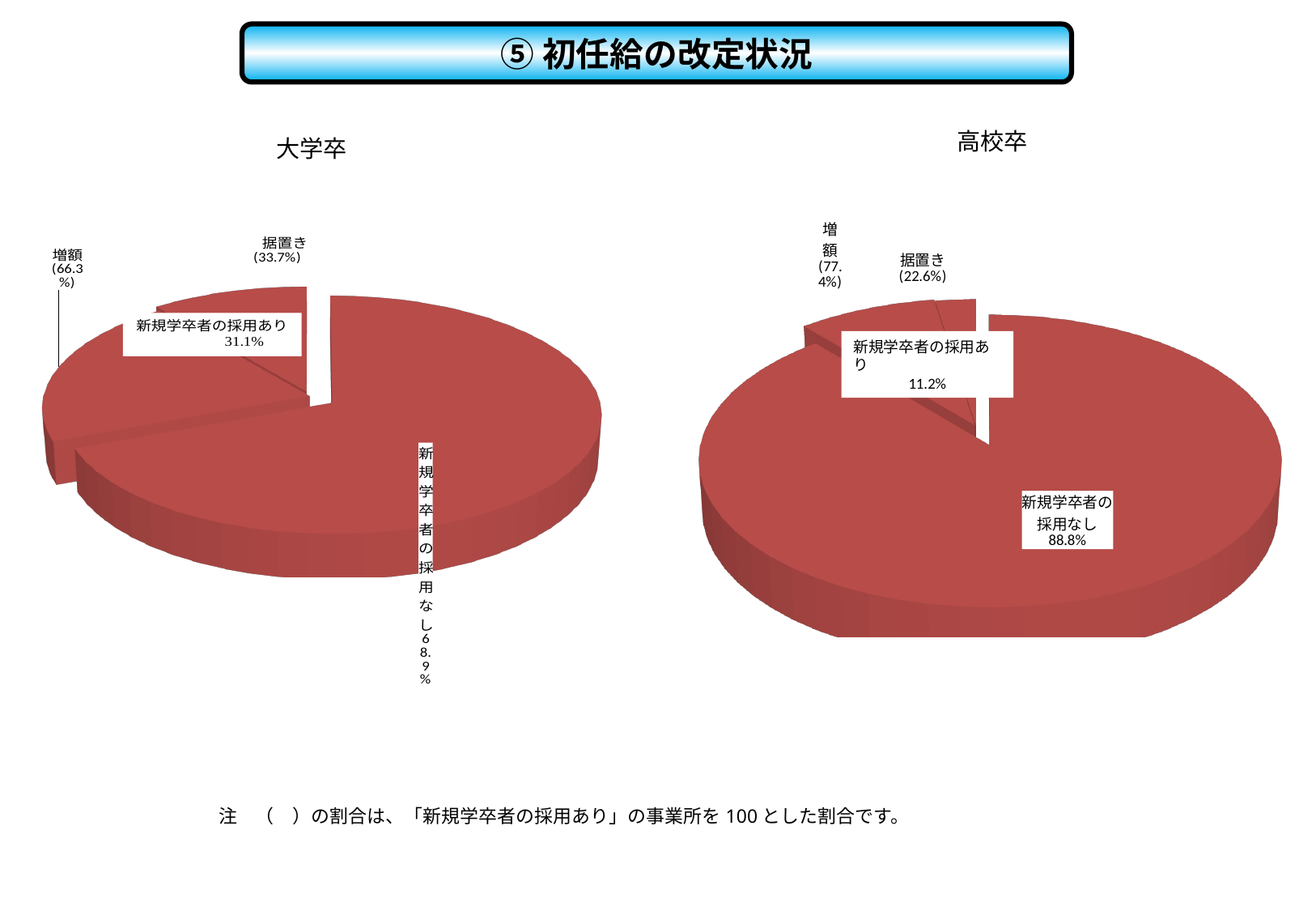
In the 大学卒 chart, what percentage is shown for 新規学卒者の採用なし? 68.9% In the 高校卒 chart, what percentage is shown for 新規学卒者の採用あり? 11.2% In the 高校卒 chart, what percentage is shown for 新規学卒者の採用なし? 88.8% Which chart has the larger share for 新規学卒者の採用なし, 大学卒 or 高校卒? 高校卒 In the 大学卒 chart, what percentage is shown for 新規学卒者の採用あり? 31.1% In the 大学卒 chart, what percentage is shown in parentheses for 増額? 66.3% What type of chart is used for 大学卒 and 高校卒 on this slide? Pie chart What is the title of the slide? ⑤ 初任給の改定状況 In the 高校卒 chart, what percentage is shown in parentheses for 据置き? 22.6% In the 大学卒 chart, what is the difference between the 増額 and 据置き percentages shown in parentheses? 32.6 percentage points In the 高校卒 chart, what percentage is shown in parentheses for 増額? 77.4% What is the difference between the 新規学卒者の採用なし share in the 高校卒 chart and in the 大学卒 chart? 19.9 percentage points